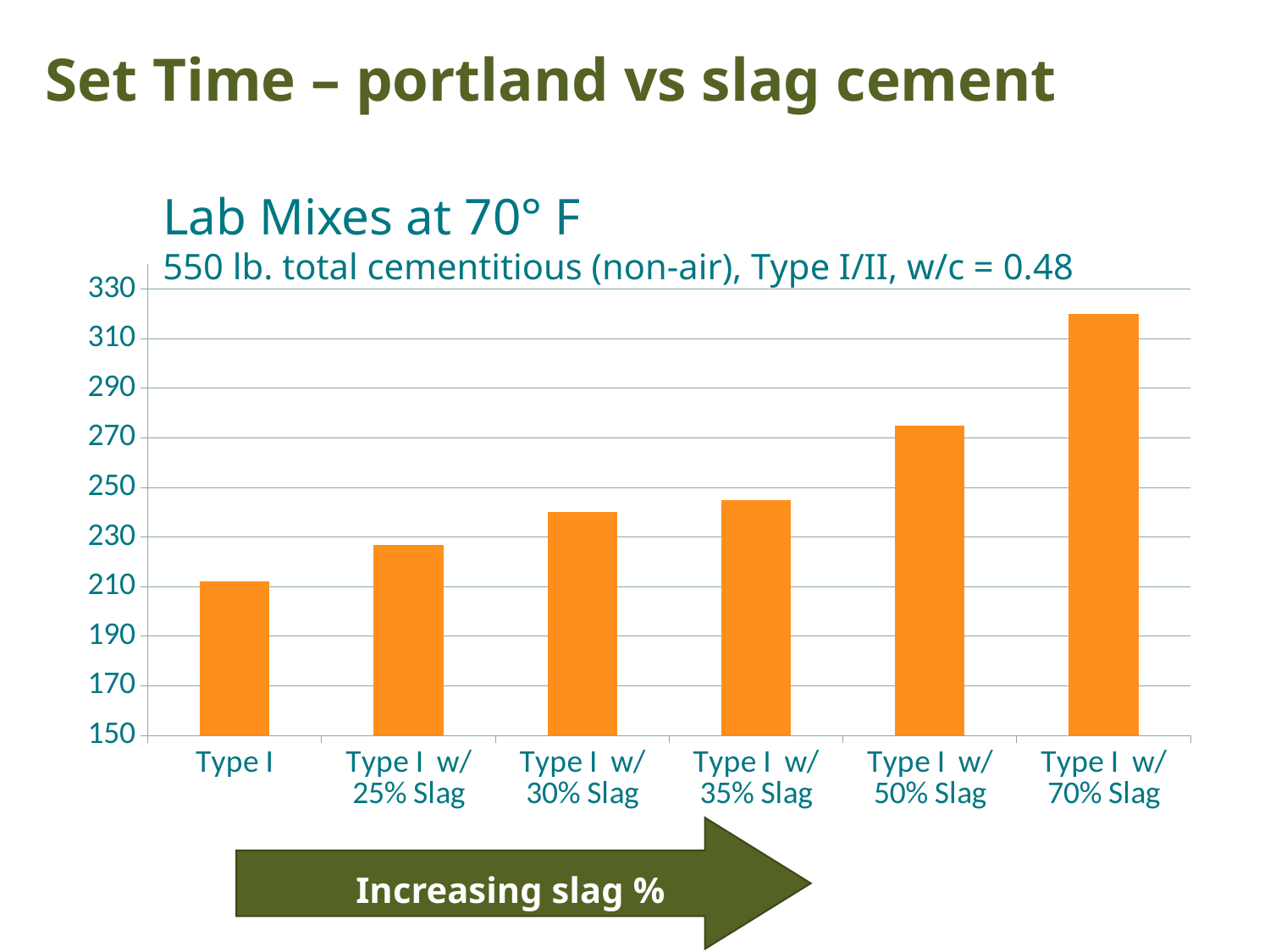
Which is larger, the value for Type I w/ 50% Slag or the value for Type I w/ 30% Slag? Type I w/ 50% Slag Is the value for Type I w/ 50% Slag greater or less than 270? greater Which mix has the lowest set time on the chart? Type I Is the value for Type I w/ 70% Slag greater or less than 310? greater Is the value for Type I greater or less than 230? less What is the title shown above the chart? Lab Mixes at 70° F What does the arrow below the x axis say? Increasing slag % How many categories (mixes) are plotted on the chart? 6 Do the set time values rise or fall as the slag percentage increases along the x axis? rise What kind of chart is shown on the slide? bar chart Which mix has the highest set time on the chart? Type I w/ 70% Slag